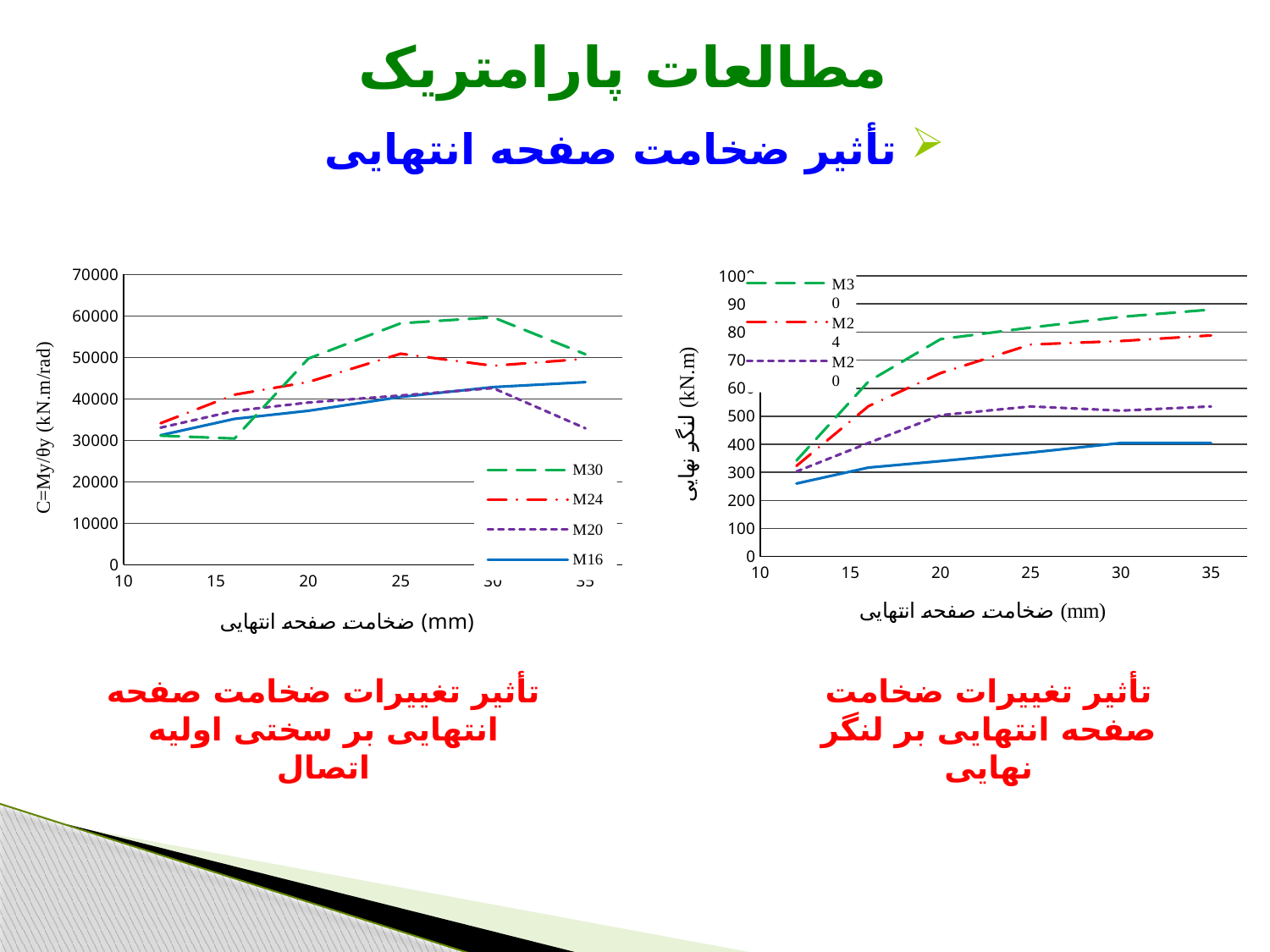
In the left chart (C=My/θy), which is larger at 15 mm: M24 or M30? M24 In the left chart (C=My/θy), does the M16 series rise or fall as end plate thickness increases? rise In the left chart (C=My/θy), is the value for M16 at 12 mm greater or less than 40000? less In the right chart (final moment), which is larger at 25 mm: M24 or M20? M24 In the right chart (final moment), is the value for M16 at 12 mm greater or less than 300? less What kind of chart is the left chart (C=My/θy vs end plate thickness)? line chart In the left chart (C=My/θy), is the value for M30 at 25 mm greater or less than 50000? greater In the right chart (final moment), which series has the lowest value at 35 mm? M16 In the left chart (C=My/θy), which series has the lowest value at 35 mm? M20 What kind of chart is the right chart (final moment vs end plate thickness)? line chart In the left chart (C=My/θy), which series has the highest value at 25 mm? M30 How many series does the legend of the left chart (C=My/θy) list? 4